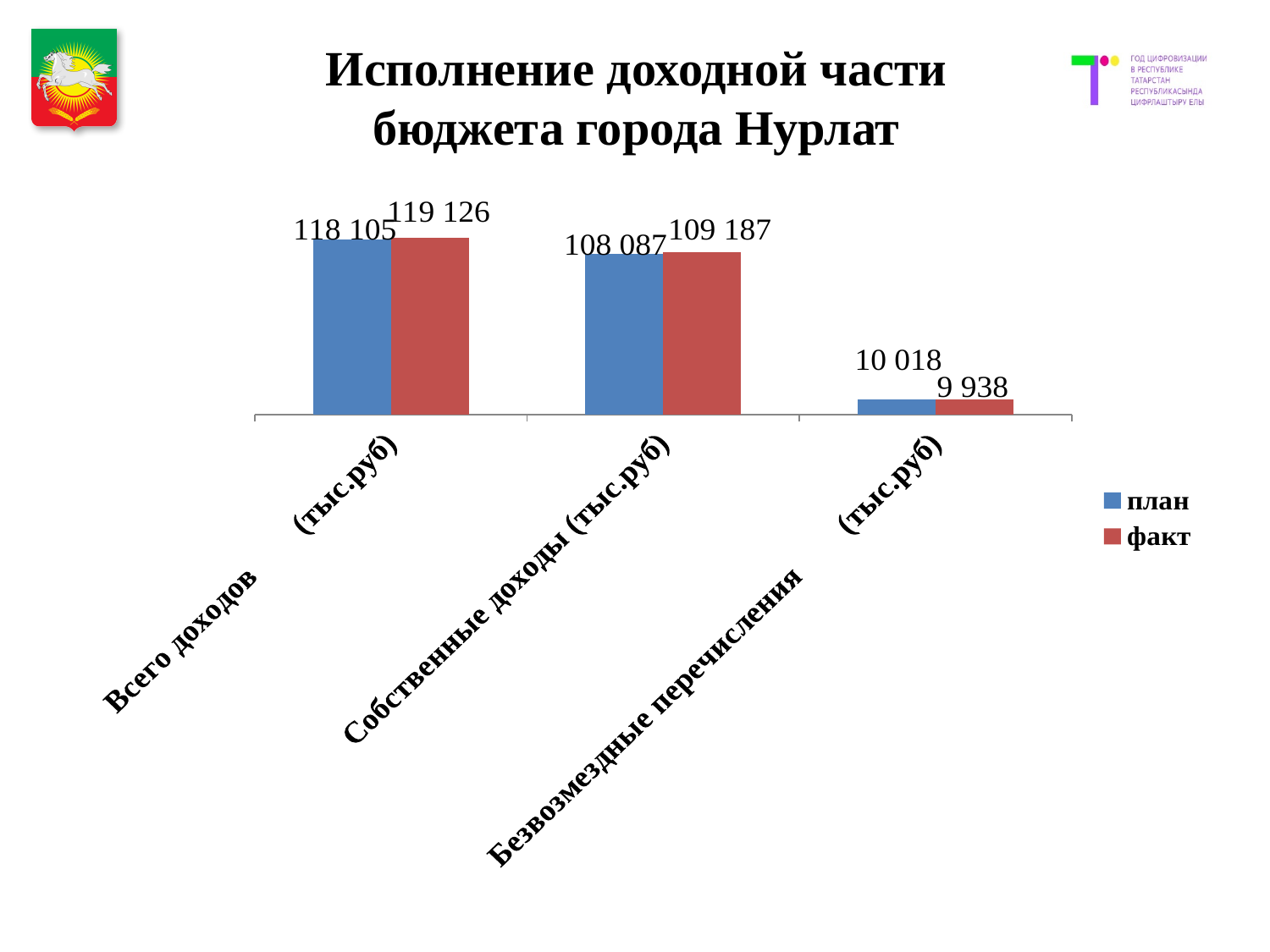
Which category has the highest план value? Всего доходов (тыс.руб) What is the план value for Собственные доходы (тыс.руб)? 108 087 How many series does the legend list? 2 What is the план value for Всего доходов (тыс.руб)? 118 105 For Безвозмездные перечисления (тыс.руб), which is larger: план or факт? план What is the difference between the факт and план values for Собственные доходы (тыс.руб)? 1 100 Which category has the lowest факт value? Безвозмездные перечисления (тыс.руб) What kind of chart is shown on the slide? bar chart How many categories are shown on the x axis? 3 What is the difference between the факт and план values for Всего доходов (тыс.руб)? 1 021 What is the факт value for Всего доходов (тыс.руб)? 119 126 What is the факт value for Безвозмездные перечисления (тыс.руб)? 9 938